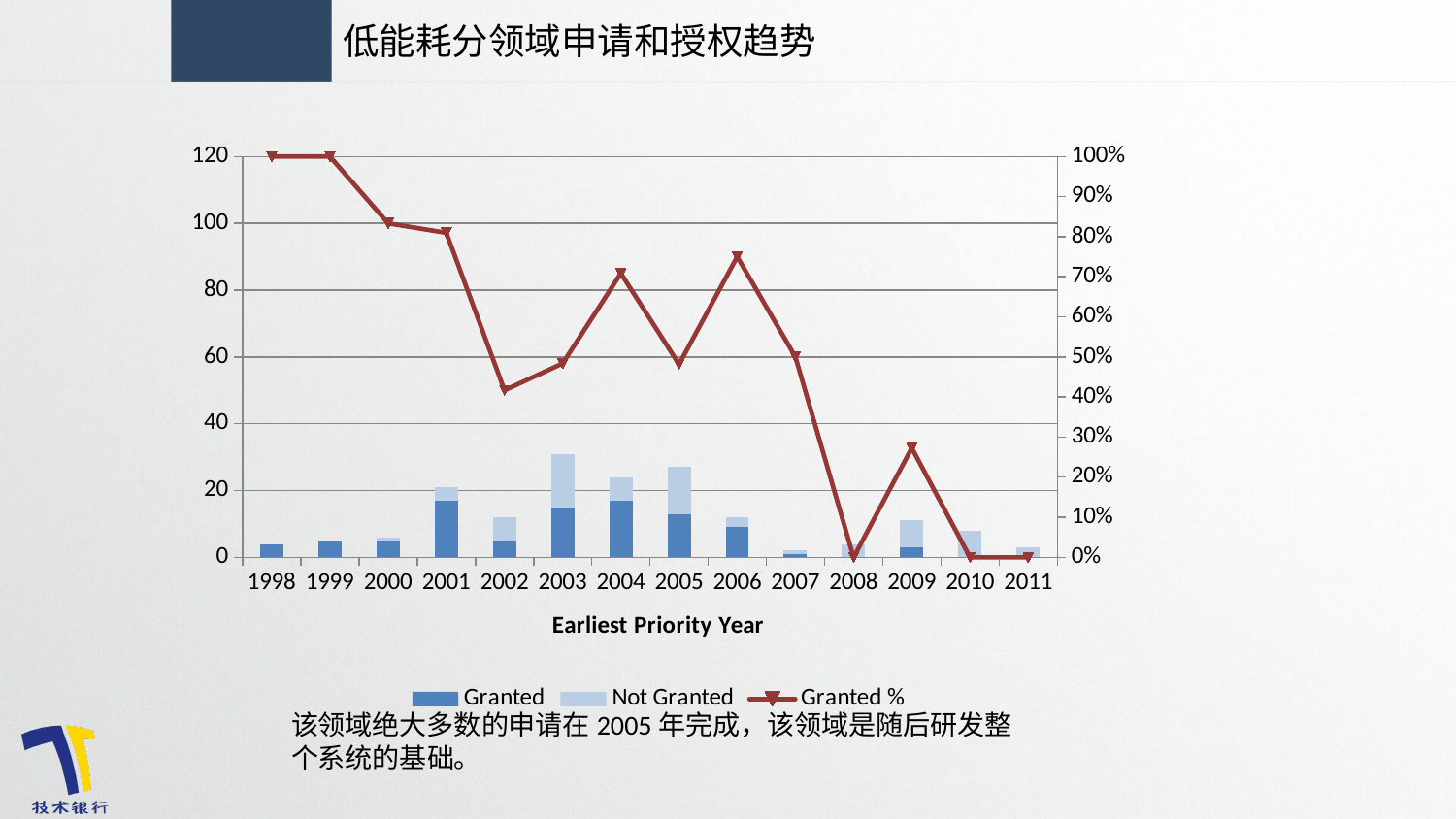
How many years are shown on the x axis of the chart? 14 How many series does the chart legend list? 3 What is the Granted % value for 2010? 0% Is the total height of the stacked bar for 2003 greater or less than 20? greater What is the Granted % value for 1998? 100% Which year has the tallest stacked bar (Granted plus Not Granted)? 2003 Does the Granted % line overall rise or fall from 1998 to 2011? fall What is the title of the x axis? Earliest Priority Year Is the Granted % value for 2002 greater or less than 50%? less Which is larger, the Granted % value for 2004 or for 2005? 2004 What kind of chart is shown on the slide? A combination of a stacked bar chart and a line chart Is the Granted % value for 2004 greater or less than 60%? greater